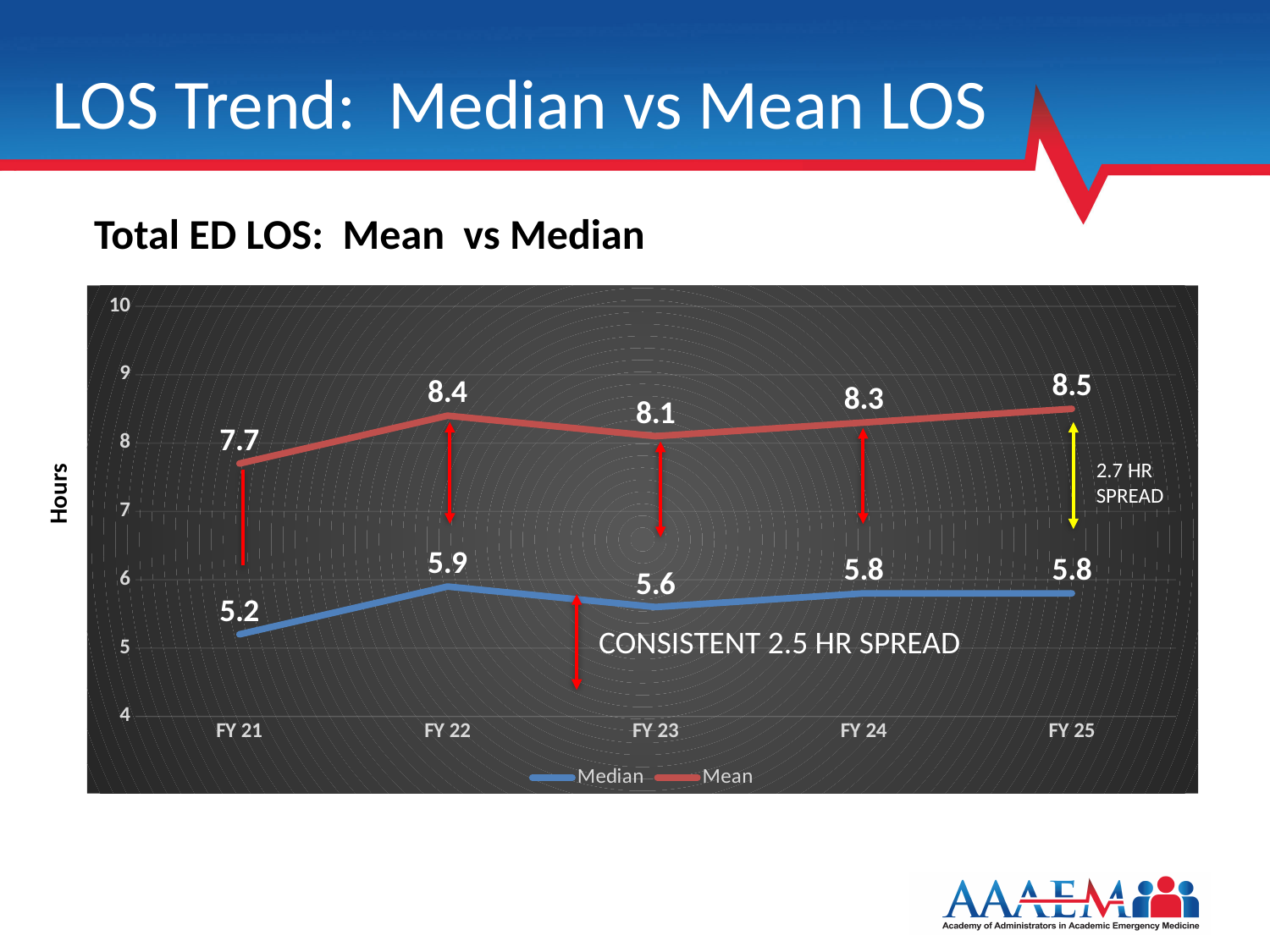
What is the Mean value for FY 22? 8.4 How many fiscal years are shown on the x axis? 5 Which is larger in FY 22, the Mean or the Median? Mean What is the Mean value for FY 21? 7.7 What is the Median value for FY 23? 5.6 What is the difference between the Mean and Median values in FY 25? 2.7 What kind of chart is shown? line chart In which fiscal year is the Mean highest? FY 25 Is the Mean value for FY 24 greater or less than 8? greater What is the label on the vertical axis? Hours In which fiscal year is the Median lowest? FY 21 How many series does the legend list? 2